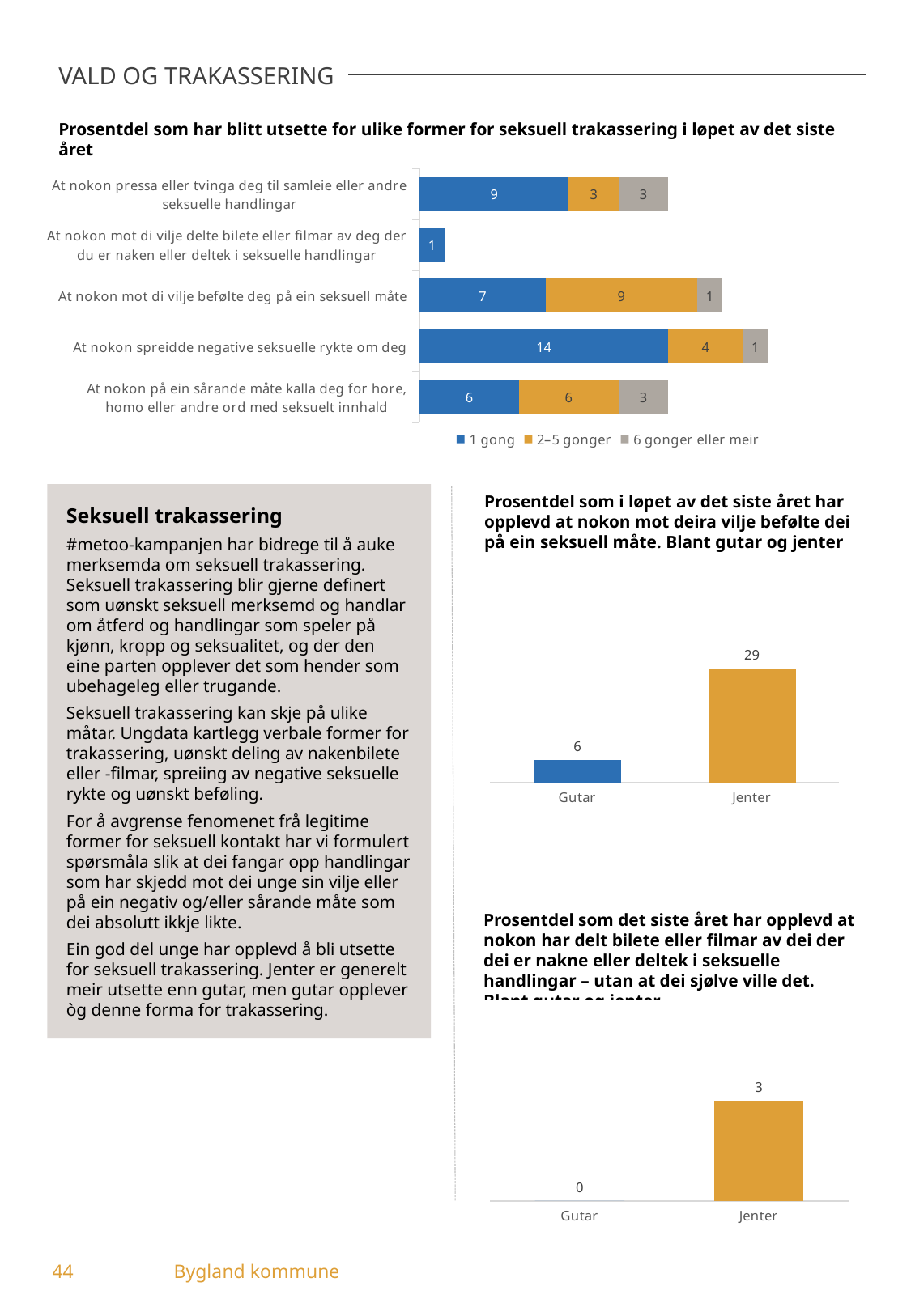
In the top chart, what is the total of the stacked bar for 'At nokon spreidde negative seksuelle rykte om deg'? 19 In the top chart, which category has the highest '1 gong' value? At nokon spreidde negative seksuelle rykte om deg In the top chart, what is the difference between the '1 gong' values for 'At nokon spreidde negative seksuelle rykte om deg' and 'At nokon pressa eller tvinga deg til samleie eller andre seksuelle handlingar'? 5 What kind of chart is the top chart on the slide? Stacked bar chart In the top chart, how many categories are shown? 5 In the top chart, how many series does the legend list? 3 In the middle chart about 'befølte dei på ein seksuell måte', what is the value for Jenter? 29 In the top chart, what is the total of the stacked bar for 'At nokon på ein sårande måte kalla deg for hore, homo eller andre ord med seksuelt innhald'? 15 In the top chart, what is the '1 gong' value for 'At nokon spreidde negative seksuelle rykte om deg'? 14 In the bottom chart about 'delt bilete eller filmar', what is the value for Gutar? 0 In the top chart, what is the '2–5 gonger' value for 'At nokon mot di vilje befølte deg på ein seksuell måte'? 9 In the middle chart about 'befølte dei på ein seksuell måte', what is the difference between Jenter and Gutar? 23